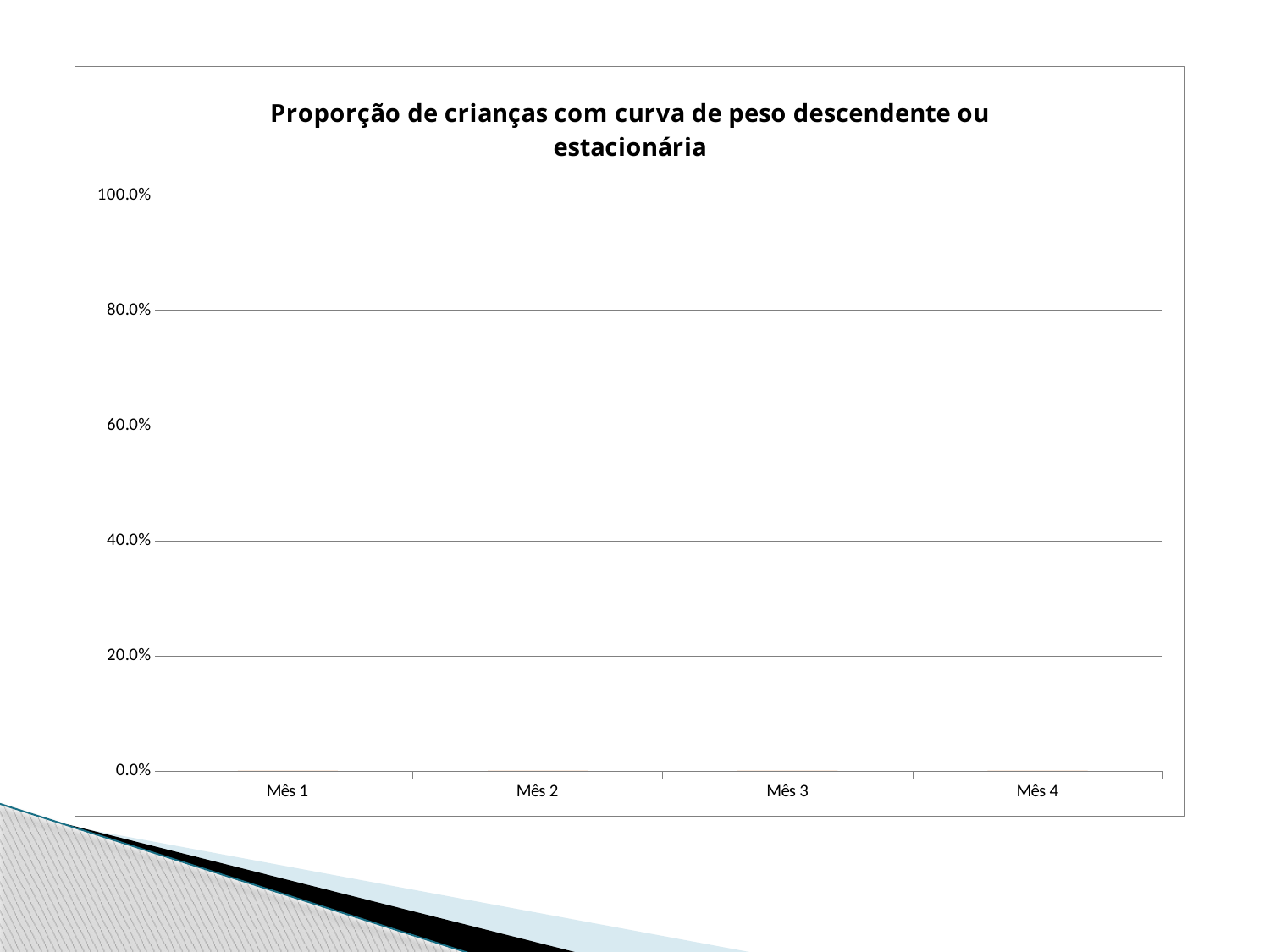
What is the title of the chart? Proporção de crianças com curva de peso descendente ou estacionária Is the value for Mês 4 greater or less than 20.0%? less How many categories are shown on the x axis of the chart? 4 Is the value for Mês 3 greater or less than 40.0%? less Is the value for Mês 1 greater or less than 20.0%? less What is the highest value labelled on the y axis of the chart? 100.0%